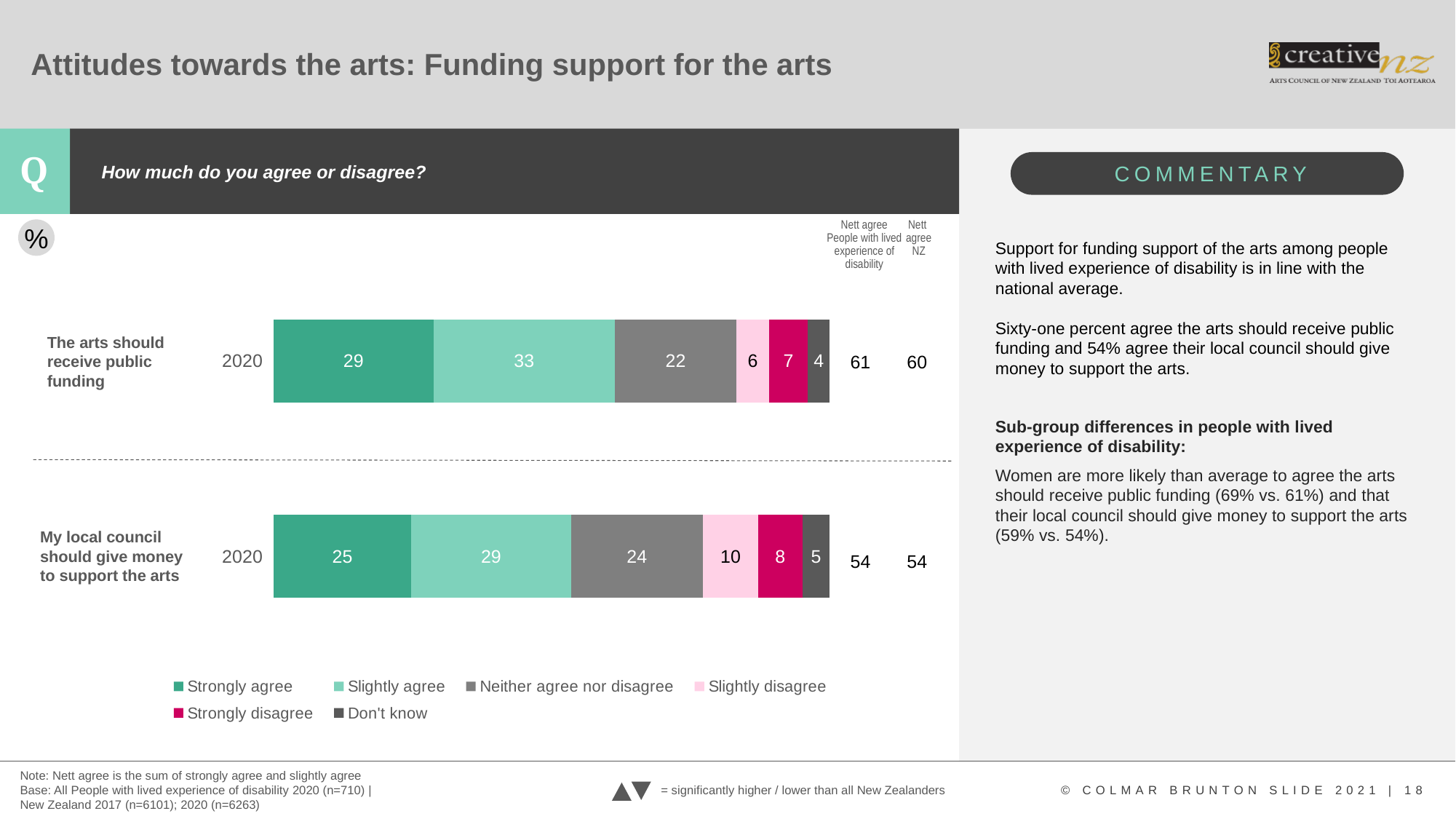
How many statements are plotted in the chart? 2 What is the Nett agree figure for people with lived experience of disability for 'The arts should receive public funding'? 61 What percentage slightly disagree that their local council should give money to support the arts? 10 What is the 'Don't know' value for 'The arts should receive public funding'? 4 How many response categories does the legend list? 6 What is the Nett agree NZ figure for 'My local council should give money to support the arts'? 54 Which statement has the larger 'Neither agree nor disagree' percentage? My local council should give money to support the arts What percentage strongly agree that the arts should receive public funding? 29 What is the difference in the 'Strongly agree' percentage between 'The arts should receive public funding' and 'My local council should give money to support the arts'? 4 What is the difference in the 'Strongly disagree' percentage between the two statements? 1 Which response category has the largest share for 'The arts should receive public funding'? Slightly agree What kind of chart is shown on the slide? Stacked bar chart